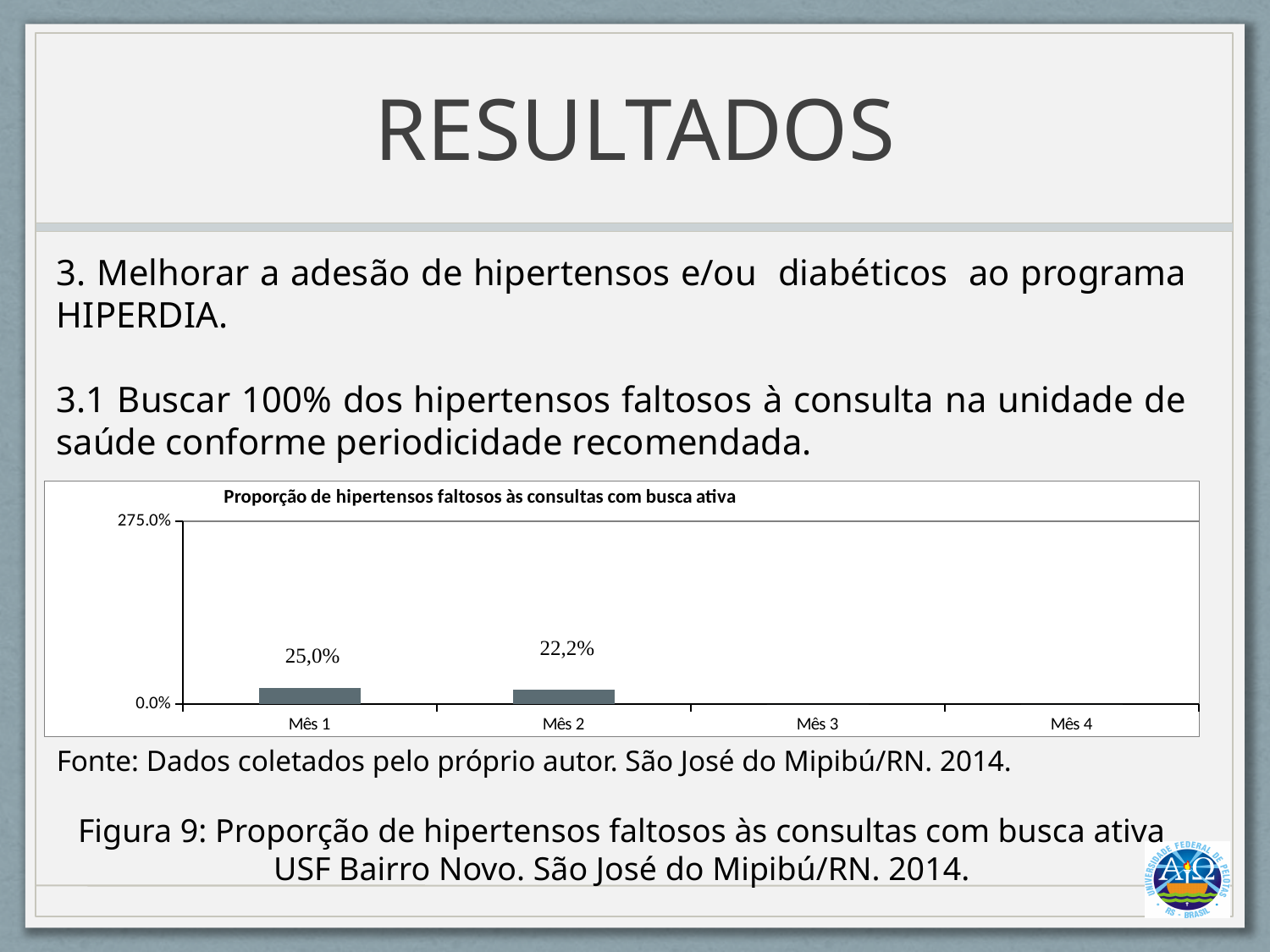
Which is larger, the value for Mês 1 or the value for Mês 2? Mês 1 Do the values rise or fall from Mês 1 to Mês 2? Fall Which of the months with a plotted bar has the lowest value? Mês 2 What is the highest tick value shown on the y axis of the chart? 275.0% What is the value for Mês 2 in the chart? 22,2% Which month has the highest plotted value in the chart? Mês 1 What kind of chart is shown on the slide? Bar chart Which months in the chart have no bar plotted? Mês 3 and Mês 4 What is the title of the chart? Proporção de hipertensos faltosos às consultas com busca ativa What is the difference between the values for Mês 1 and Mês 2? 2,8% What is the value for Mês 1 in the chart? 25,0% How many month categories are shown on the x axis of the chart? 4